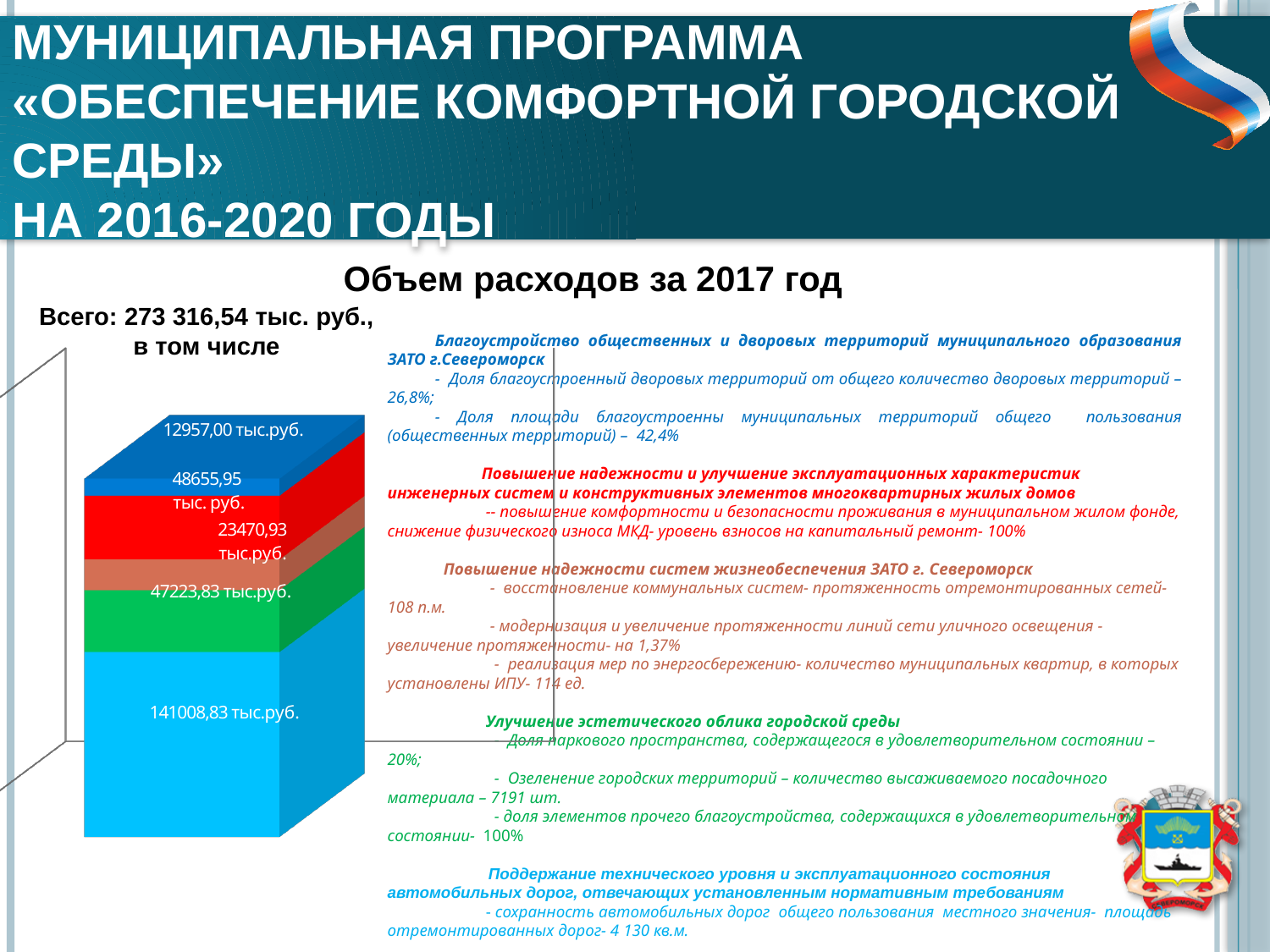
Which is larger: the red segment (48655,95) or the green segment (47223,83)? the red segment (48655,95) What value is shown on the bottom (light blue) segment of the bar? 141008,83 тыс.руб. What kind of chart is shown on the slide? stacked bar chart What is the value of the largest segment of the stacked bar? 141008,83 тыс.руб. What is the value of the smallest segment of the stacked bar? 12957,00 тыс.руб. What value is shown on the green segment of the bar? 47223,83 тыс.руб. What is the total of all segments of the stacked bar, as stated on the slide? 273 316,54 тыс. руб. What is the title shown above the chart? Объем расходов за 2017 год What is the difference between the bottom segment (141008,83) and the green segment (47223,83)? 93785,00 тыс.руб. How many segments make up the stacked bar in the chart? 5 What value is shown on the topmost (dark blue) segment of the bar? 12957,00 тыс.руб. What value is shown on the red segment of the bar? 48655,95 тыс. руб.